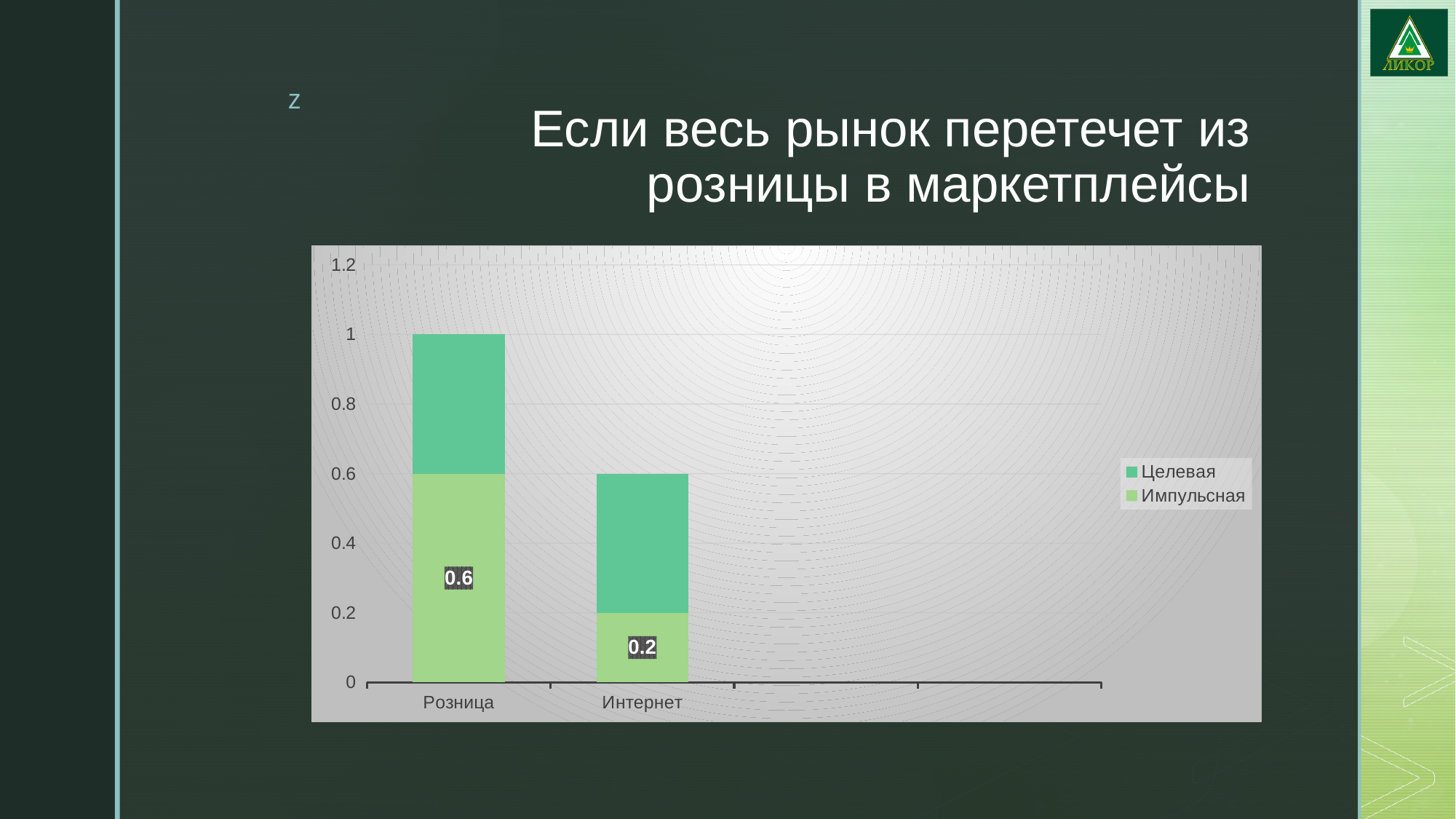
How many series does the chart legend list? 2 What is the difference between the Импульсная values for Розница and Интернет? 0.4 What is the value of Импульсная for Интернет? 0.2 Which category has the higher Импульсная value? Розница Is the total of the stacked bar for Интернет greater or less than 0.8? less What is the total height of the stacked bar for Розница? 1 How many categories are shown on the x axis of the chart? 2 What is the total height of the stacked bar for Интернет? 0.6 Which series is shown in the lighter green colour in the legend? Импульсная Which category has the lower Импульсная value? Интернет What is the value of Импульсная for Розница? 0.6 What kind of chart is shown on the slide? Stacked bar chart